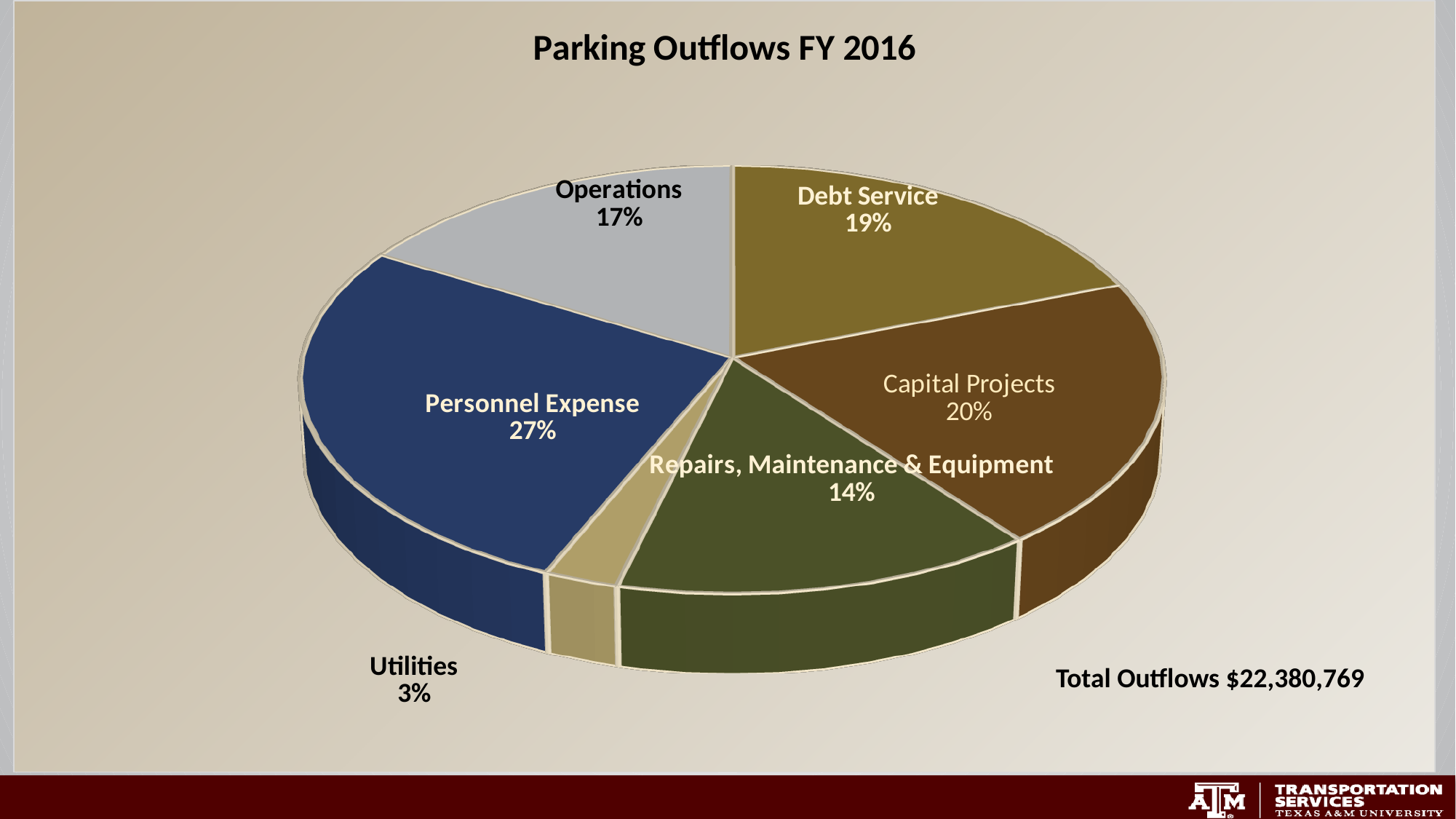
What is the total outflows amount shown on the slide? $22,380,769 What share of parking outflows is Personnel Expense? 27% What share of parking outflows is Utilities? 3% Which is larger, the share for Debt Service or the share for Operations? Debt Service What share of parking outflows is Capital Projects? 20% Which category has the largest share of parking outflows? Personnel Expense What is the difference in percentage points between Personnel Expense and Operations? 10% How many categories are shown in the pie chart? 6 What kind of chart is shown on the slide? Pie chart What is the title of the chart? Parking Outflows FY 2016 Which category has the smallest share of parking outflows? Utilities